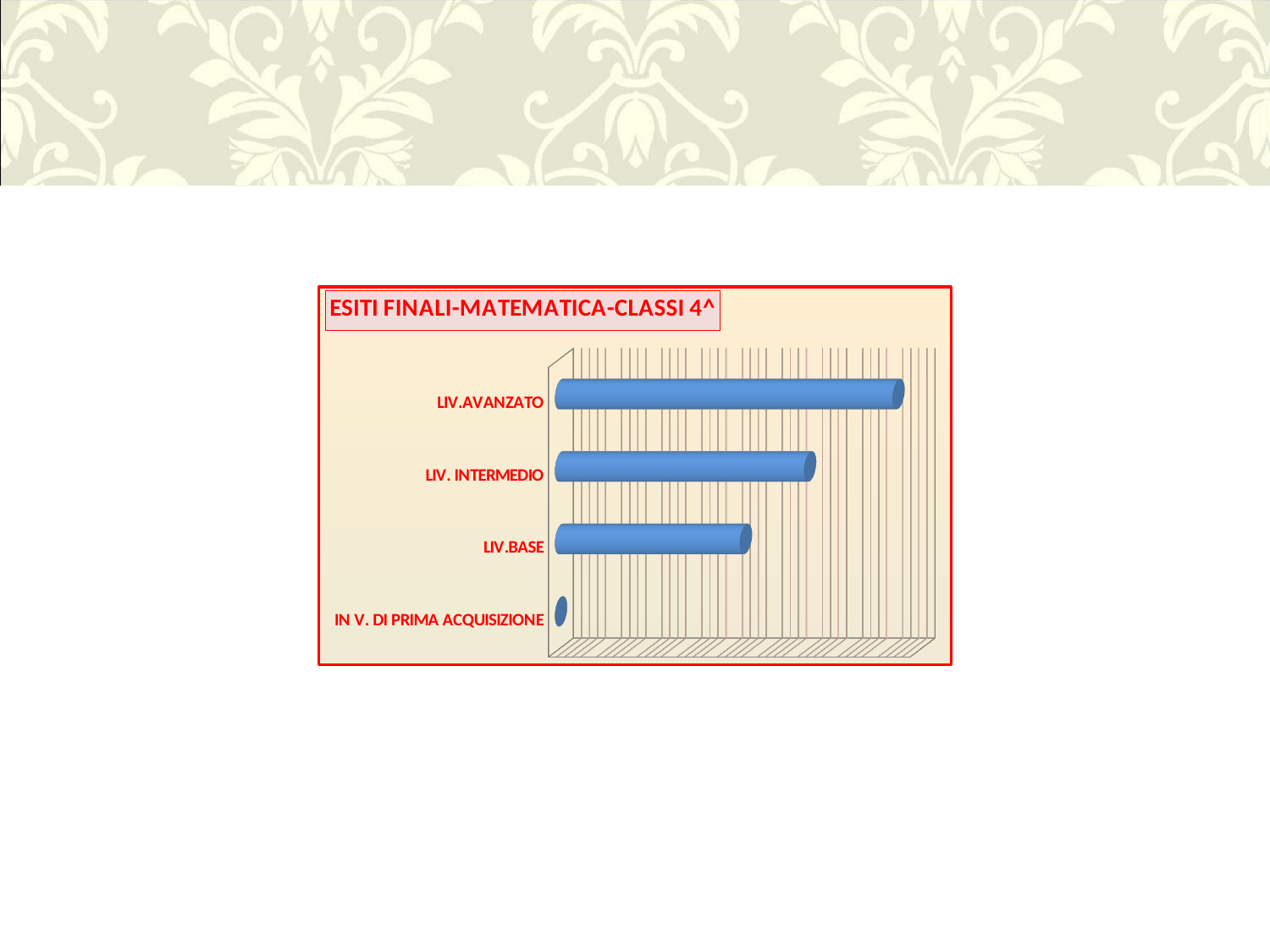
What kind of chart is shown on the slide? bar chart Do the bar values increase or decrease going from the top category to the bottom category? decrease Which is larger, the value for LIV. INTERMEDIO or the value for LIV.BASE? LIV. INTERMEDIO How many categories are shown in the chart? 4 Which category has the highest value? LIV.AVANZATO Which category has the lowest value? IN V. DI PRIMA ACQUISIZIONE Which is larger, the value for LIV.AVANZATO or the value for LIV. INTERMEDIO? LIV.AVANZATO What is the title of the chart? ESITI FINALI-MATEMATICA-CLASSI 4^ Which category is listed at the bottom of the chart? IN V. DI PRIMA ACQUISIZIONE Which is larger, the value for LIV.BASE or the value for IN V. DI PRIMA ACQUISIZIONE? LIV.BASE